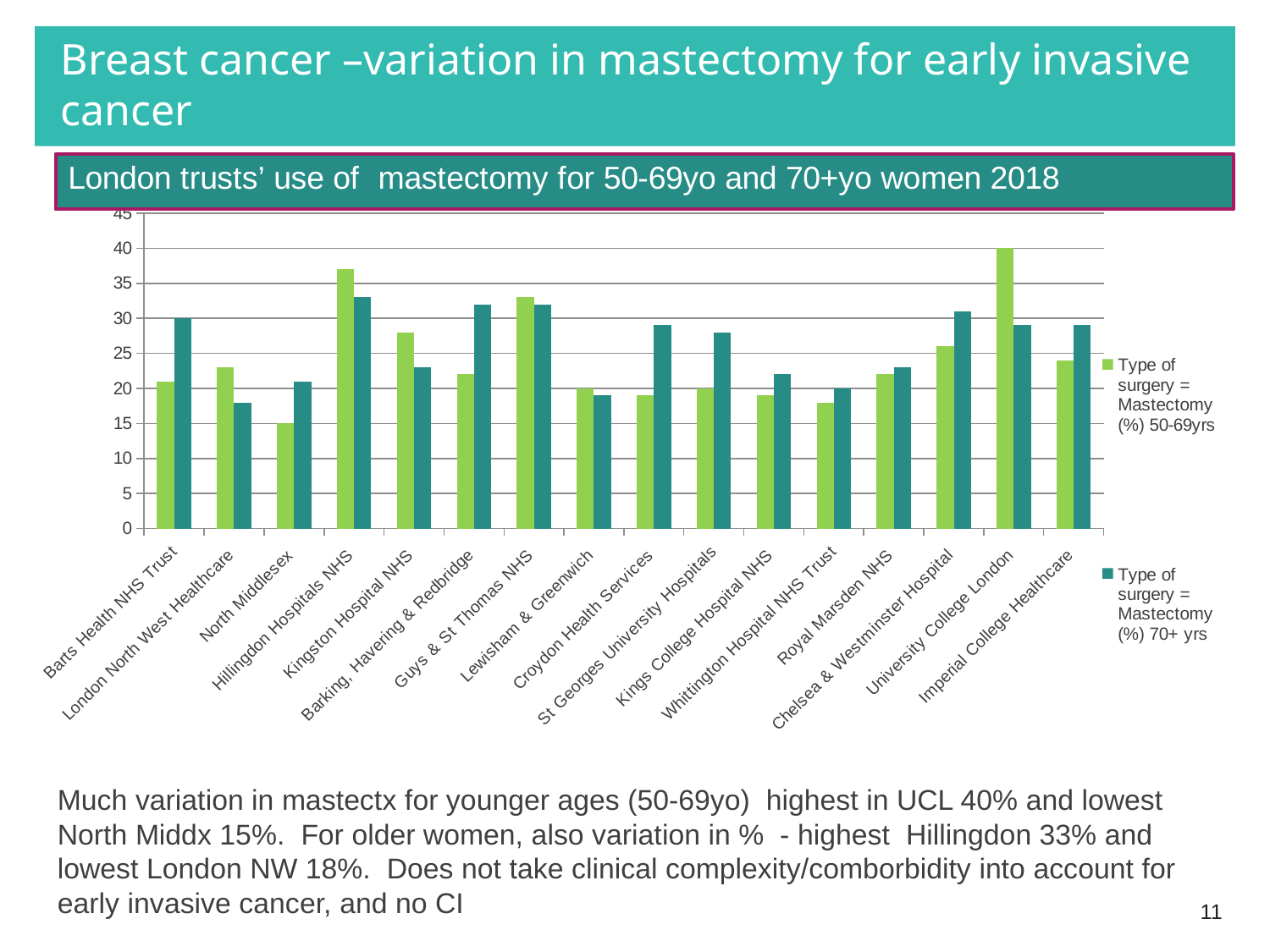
Which trust has the lowest mastectomy percentage for 50-69 year olds? North Middlesex What is the mastectomy percentage for 50-69 year olds at University College London? 40% How many series does the legend list? 2 Is the 50-69yrs mastectomy value for Hillingdon Hospitals NHS greater or less than 35? greater How many London trusts are shown on the x axis? 16 At Barts Health NHS Trust, which is larger: the mastectomy percentage for 50-69yrs or for 70+ yrs? 70+ yrs Which trust has the lowest mastectomy percentage for women aged 70+? London North West Healthcare What is the difference between the 50-69yrs mastectomy percentage at University College London and at North Middlesex? 25 What type of chart is shown on the slide? bar chart What is the mastectomy percentage for 50-69 year olds at North Middlesex? 15% Which colour represents the 50-69yrs series in the legend? light green Which trust has the highest mastectomy percentage for 50-69 year olds? University College London